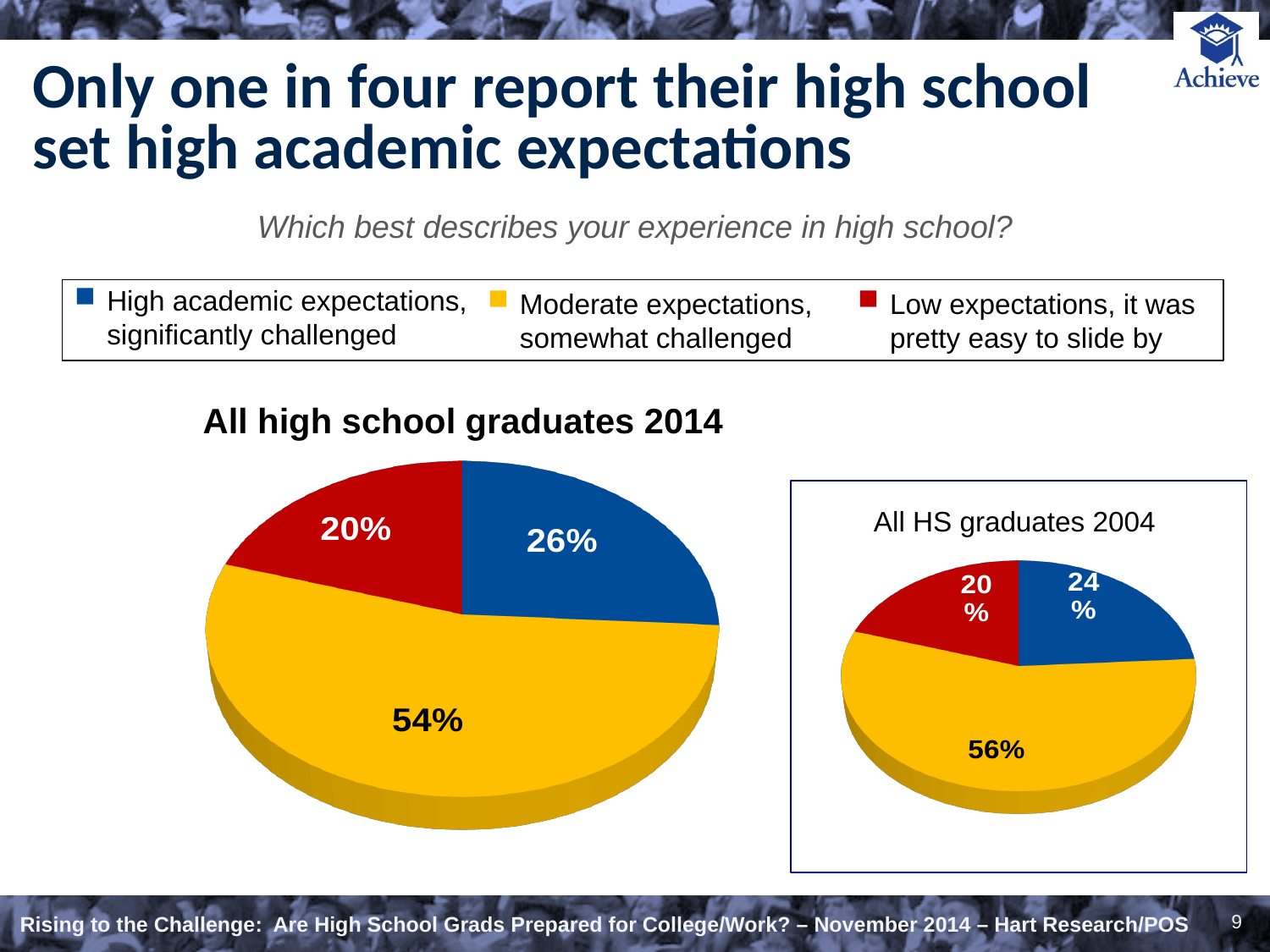
In the 'All high school graduates 2014' chart, which response has the largest share? Moderate expectations, somewhat challenged What is the difference between the moderate expectations share in the 2014 chart and the moderate expectations share in the 2004 chart? 2% How many slices does the 'All HS graduates 2004' pie chart have? 3 In the 'All HS graduates 2004' chart, what percentage reported high academic expectations, significantly challenged? 24% In the 'All high school graduates 2014' chart, what percentage reported low expectations, it was pretty easy to slide by? 20% Which is larger: the high academic expectations share in the 2014 chart or in the 2004 chart? 2014 chart (26%) In the 'All HS graduates 2004' chart, which response has the smallest share? Low expectations, it was pretty easy to slide by How many response categories does the legend list? 3 In the 'All high school graduates 2014' chart, what percentage reported moderate expectations, somewhat challenged? 54% In the 'All HS graduates 2004' chart, what percentage reported moderate expectations, somewhat challenged? 56% What kind of chart is used for 'All high school graduates 2014'? Pie chart In the 'All high school graduates 2014' chart, what percentage reported high academic expectations, significantly challenged? 26%